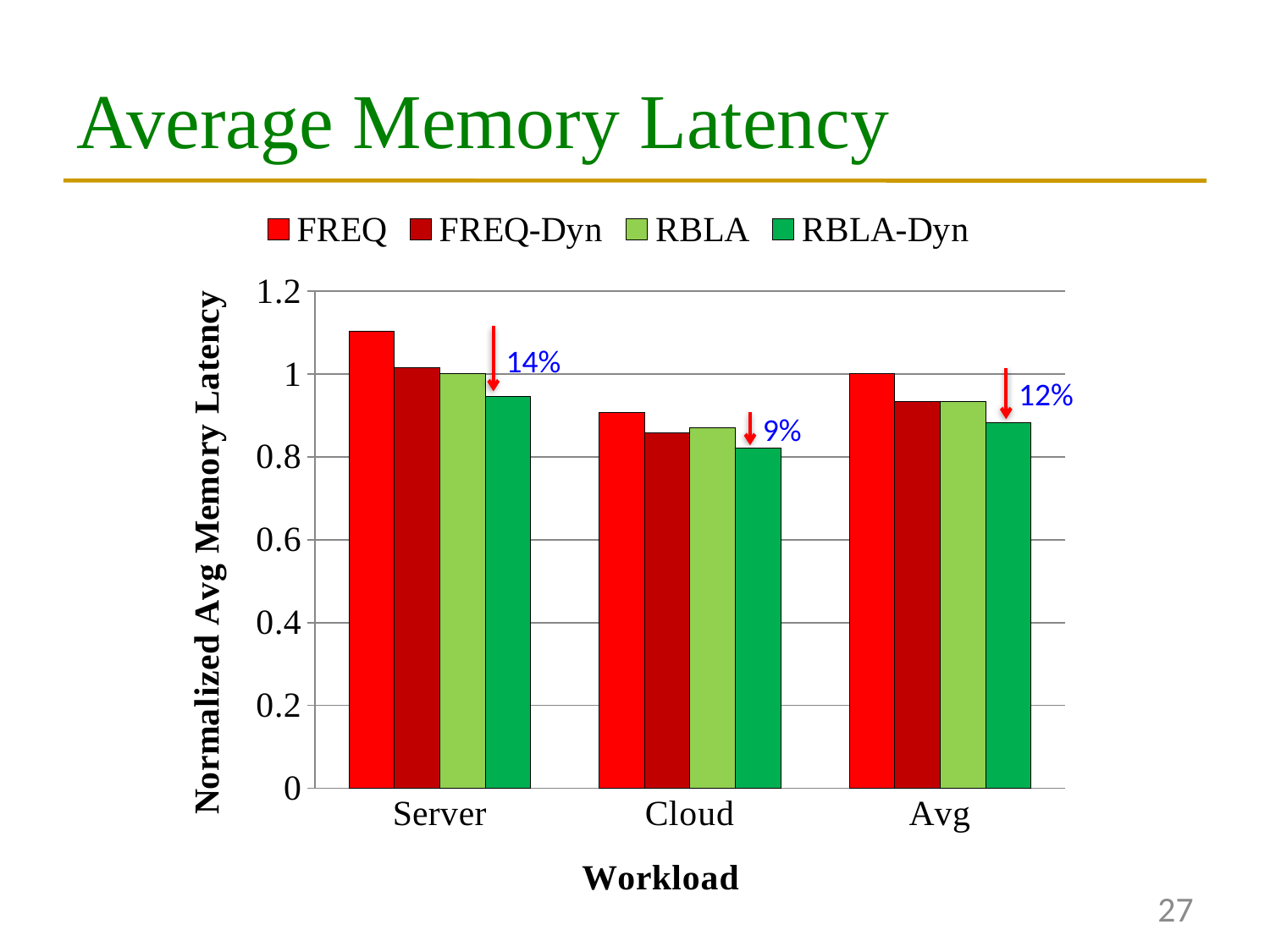
How many workload categories are shown on the x axis? 3 What percentage reduction is annotated above the RBLA-Dyn bar for the Server workload? 14% Is the FREQ value for Cloud greater or less than 1? less Which is larger: the FREQ value for Server or the FREQ value for Cloud? Server Which workload has the highest FREQ bar? Server For the Cloud workload, which series has the lowest bar? RBLA-Dyn Is the RBLA-Dyn value for Cloud greater or less than 0.8? greater What kind of chart is shown on the slide? bar chart Is the FREQ value for Server greater or less than 1? greater How many series does the legend list? 4 What is the title of the y axis? Normalized Avg Memory Latency